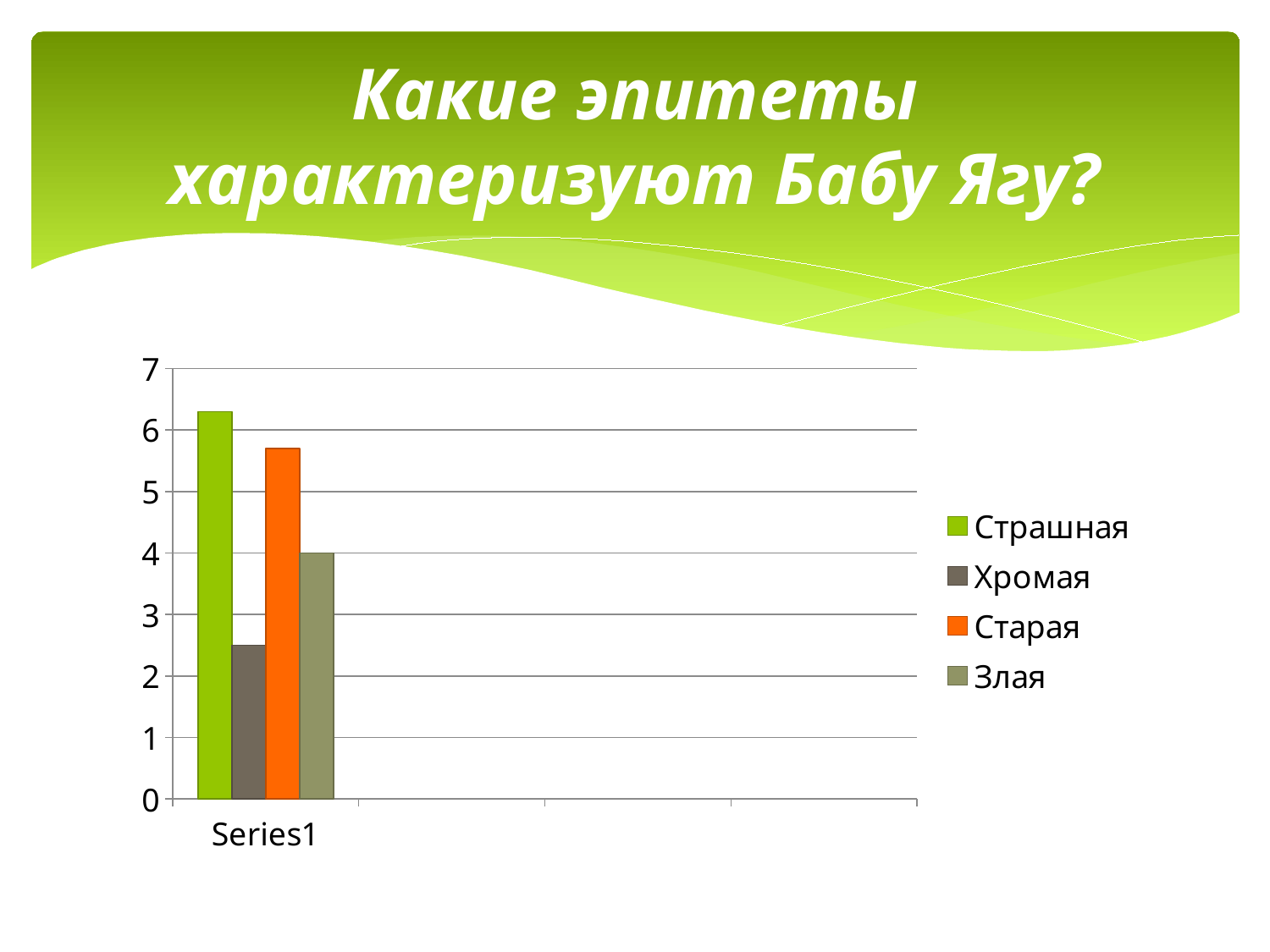
Which series has the highest bar? Страшная How many series does the legend list? 4 Is the value for Страшная greater or less than 6? greater What kind of chart is shown on the slide? bar chart What is the value for Злая? 4 What is the title of the slide above the chart? Какие эпитеты характеризуют Бабу Ягу? Which series is shown in orange? Старая Is the value for Хромая greater or less than 3? less Which is larger, the value for Старая or the value for Злая? Старая Which series has the lowest bar? Хромая Which is larger, the value for Хромая or the value for Злая? Злая Is the value for Старая greater or less than 5? greater